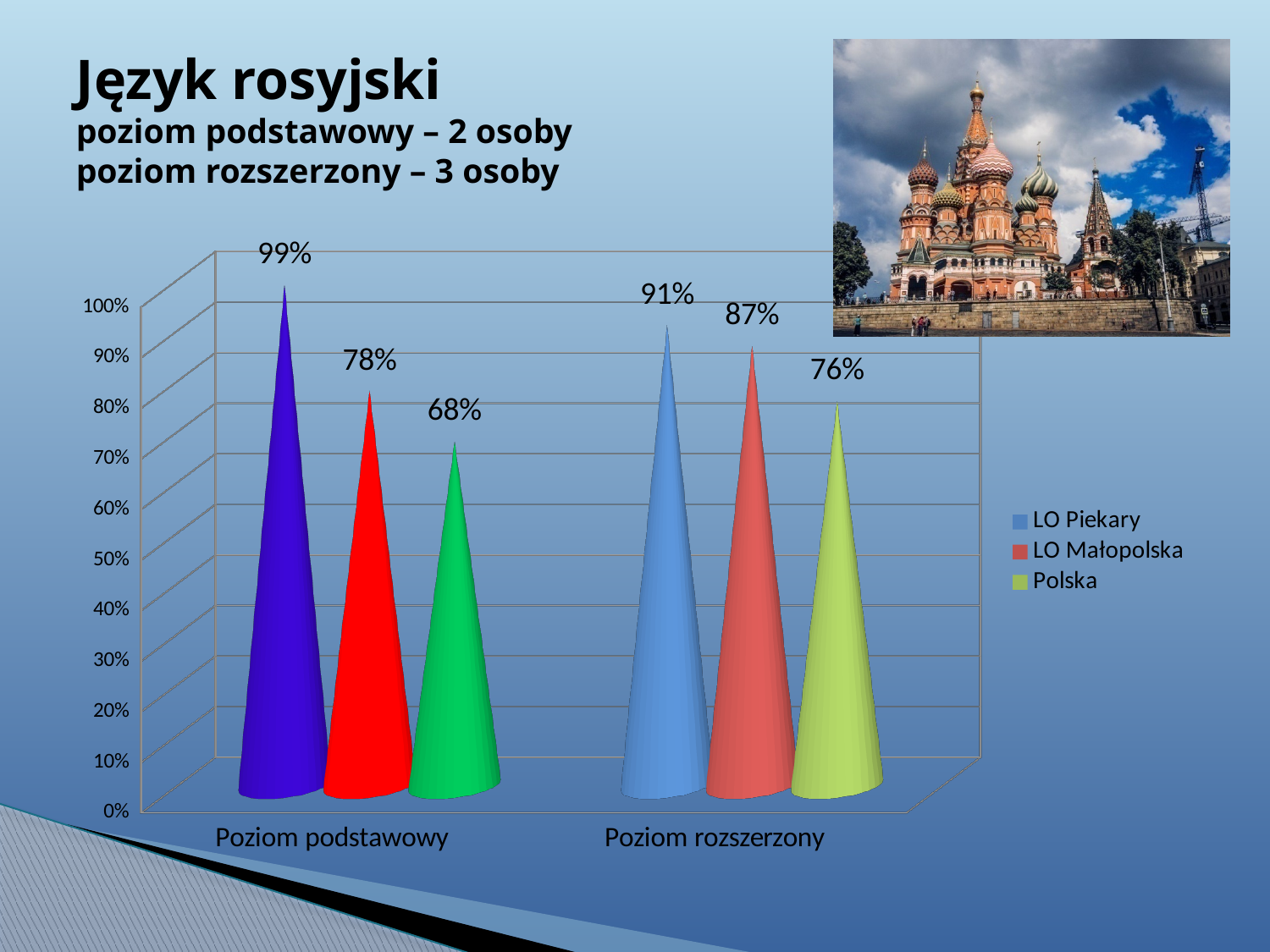
What is the value for Polska at Poziom rozszerzony? 76% Which series has the lowest value at Poziom podstawowy? Polska What is the value for LO Małopolska at Poziom podstawowy? 78% Which series is shown in green in the legend? Polska What is the value for LO Piekary at Poziom podstawowy? 99% How many categories are shown on the x axis? 2 What kind of chart is shown on the slide? bar chart Which series has the highest value at Poziom rozszerzony? LO Piekary Which is larger: LO Małopolska at Poziom podstawowy or LO Małopolska at Poziom rozszerzony? Poziom rozszerzony What is the difference between LO Małopolska and Polska at Poziom rozszerzony? 11% What is the difference between LO Piekary and Polska at Poziom podstawowy? 31% How many series does the legend list? 3